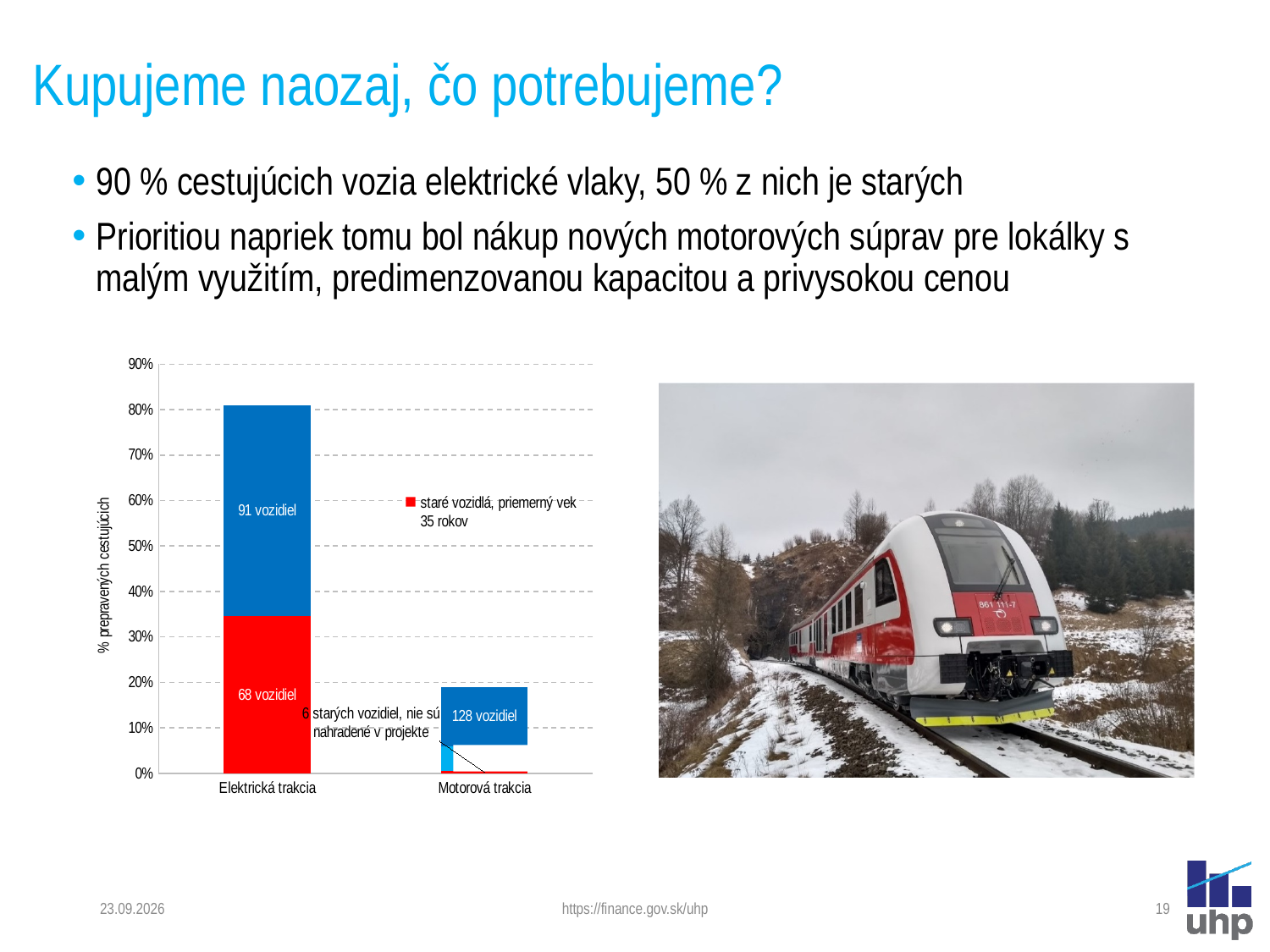
Which category has the lower total share of transported passengers? Motorová trakcia What kind of chart is shown on the slide? bar chart What is the label of the y axis of the chart? % prepravených cestujúcich What is the data label on the red segment of the Elektrická trakcia bar? 68 vozidiel How many categories are shown on the x axis of the chart? 2 Is the total value for Motorová trakcia greater or less than 30%? less Which category has the higher total share of transported passengers? Elektrická trakcia What is the data label on the blue segment of the Elektrická trakcia bar? 91 vozidiel Is the red segment of the Elektrická trakcia bar greater or less than 30%? greater Is the total value for Elektrická trakcia greater or less than 70%? greater What is the data label on the blue segment of the Motorová trakcia bar? 128 vozidiel According to the annotation, how many old vehicles in Motorová trakcia are not replaced in the project? 6